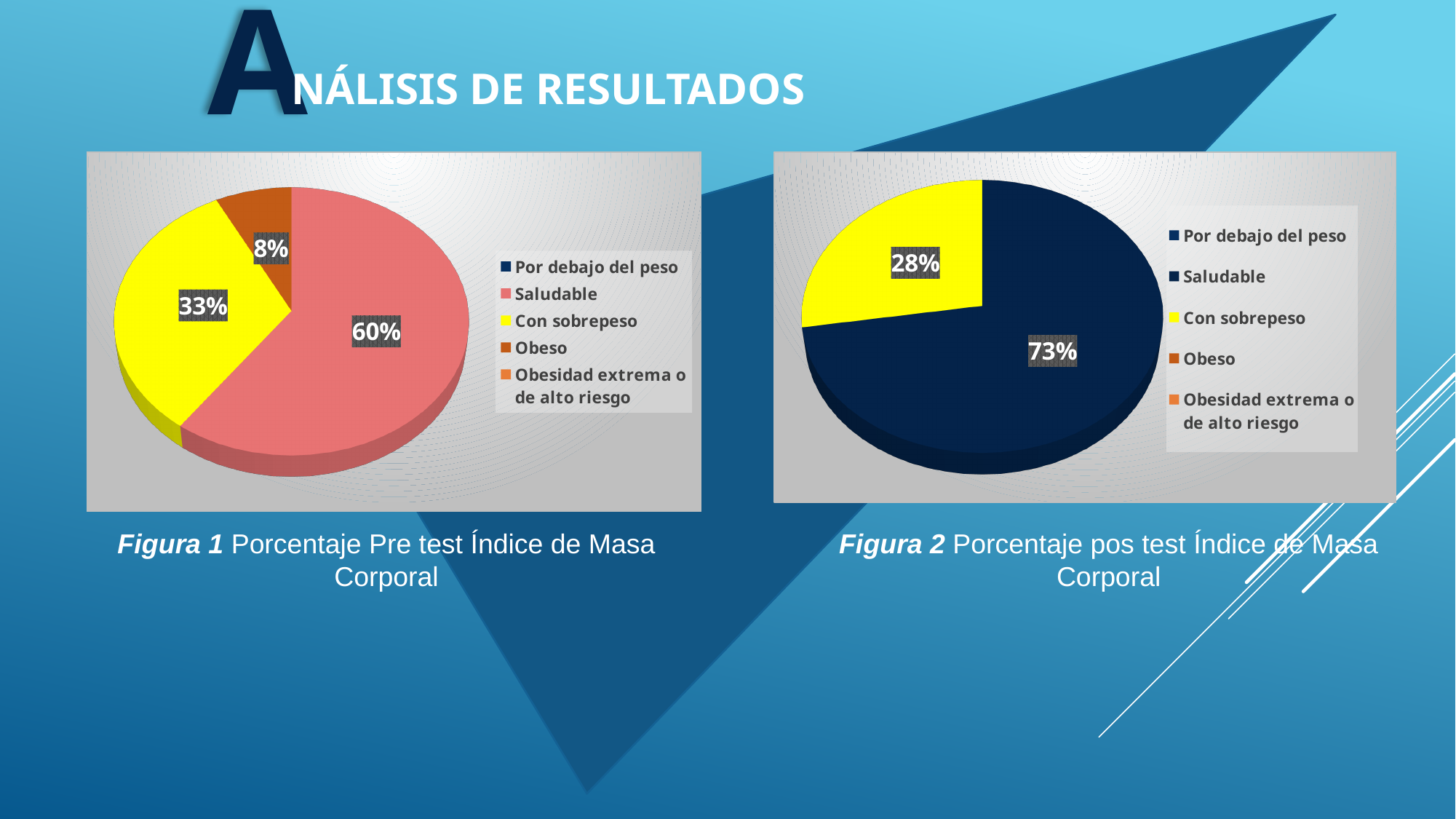
In Figura 1 (left chart), what is the difference in percentage points between Saludable and Con sobrepeso? 27 In Figura 1 (left chart), which is larger, Con sobrepeso or Obeso? Con sobrepeso In Figura 1 (left chart), what percentage is shown for Saludable? 60% In Figura 1 (left chart), what percentage is shown for Con sobrepeso? 33% In Figura 1 (left chart), which of the labelled slices is the smallest? Obeso How many slices with data labels does Figura 2 (right chart) show? 2 In Figura 2 (right chart), what percentage is shown for Con sobrepeso? 28% In Figura 1 (left chart), what percentage is shown for Obeso? 8% In Figura 1 (left chart), which category has the largest slice? Saludable In Figura 2 (right chart), what percentage is shown on the largest slice? 73% What type of chart is Figura 1 (left chart)? Pie chart How many entries does the legend of Figura 1 (left chart) list? 5